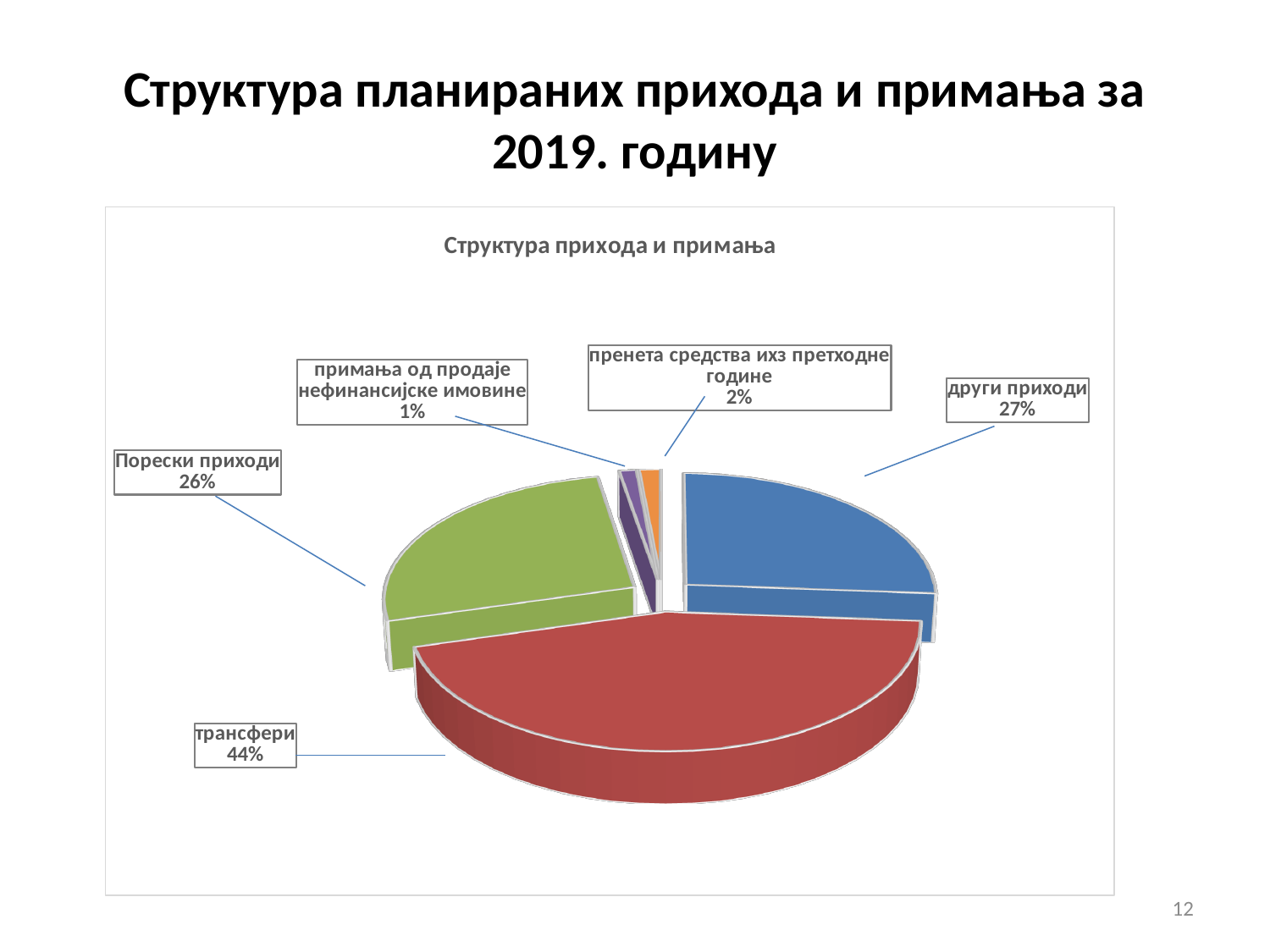
What share of the pie does пренета средства ихз претходне године have? 2% What share of the pie does трансфери have? 44% Which category has the smallest share of the pie? примања од продаје нефинансијске имовине What kind of chart is shown on the slide? pie chart What share of the pie does примања од продаје нефинансијске имовине have? 1% Which slice is larger, други приходи or Порески приходи? други приходи What is the title of the chart? Структура прихода и примања How many slices does the pie chart have? 5 Which category has the largest share of the pie? трансфери What is the difference in percentage points between трансфери and Порески приходи? 18